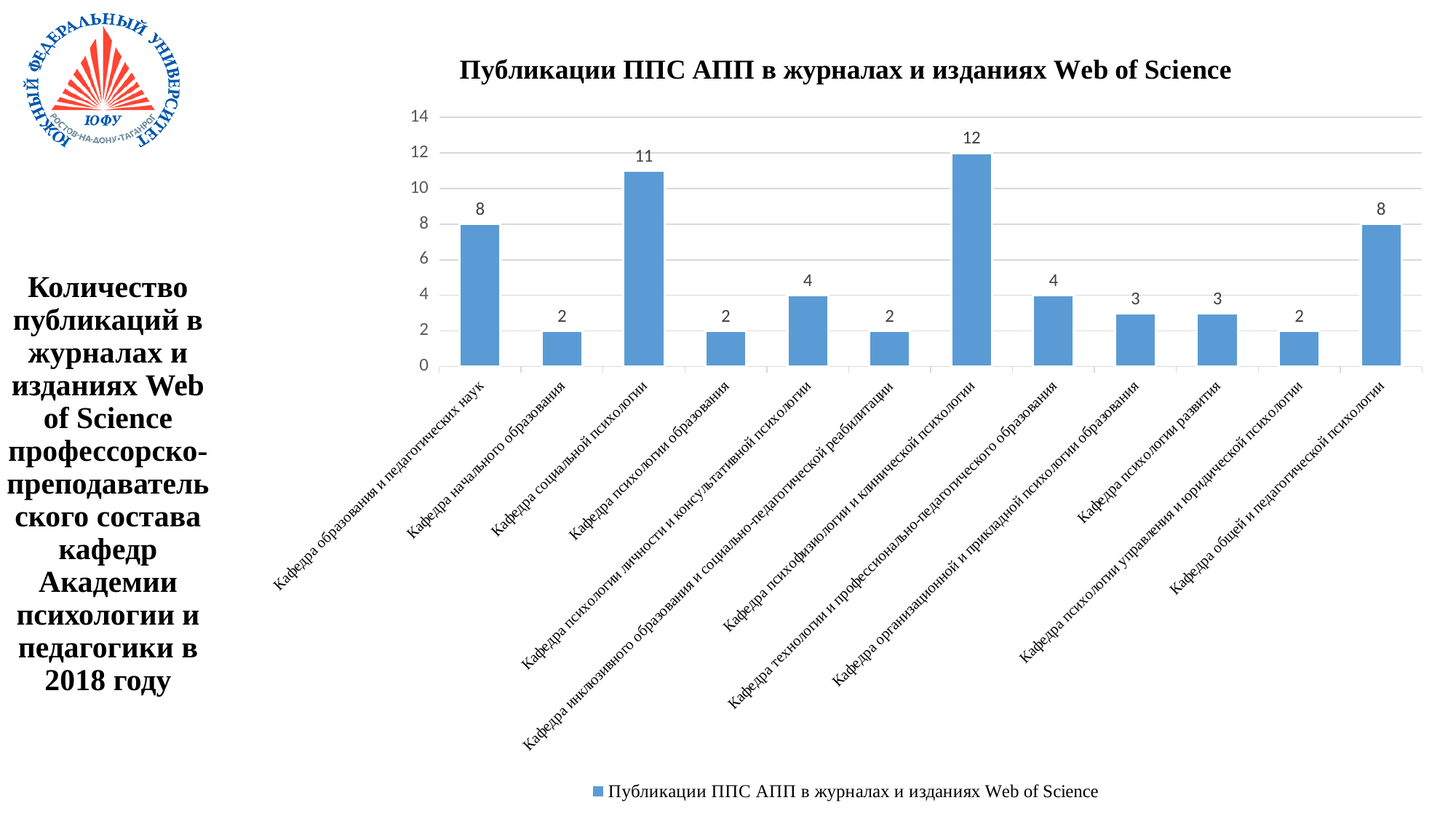
What is the value for Кафедра психологии развития? 3 How many series does the legend list? 1 What is the title of the chart? Публикации ППС АПП в журналах и изданиях Web of Science How many categories (departments) are shown in the chart? 12 What is the lowest value shown in the chart? 2 What is the difference between the values for Кафедра образования и педагогических наук and Кафедра начального образования? 6 What is the value for Кафедра общей и педагогической психологии? 8 What is the value for Кафедра социальной психологии? 11 What type of chart is shown on the slide? bar chart What is the difference between the values for Кафедра психофизиологии и клинической психологии and Кафедра социальной психологии? 1 Which department has the highest value? Кафедра психофизиологии и клинической психологии Which is larger: the value for Кафедра образования и педагогических наук or the value for Кафедра психологии личности и консультативной психологии? Кафедра образования и педагогических наук